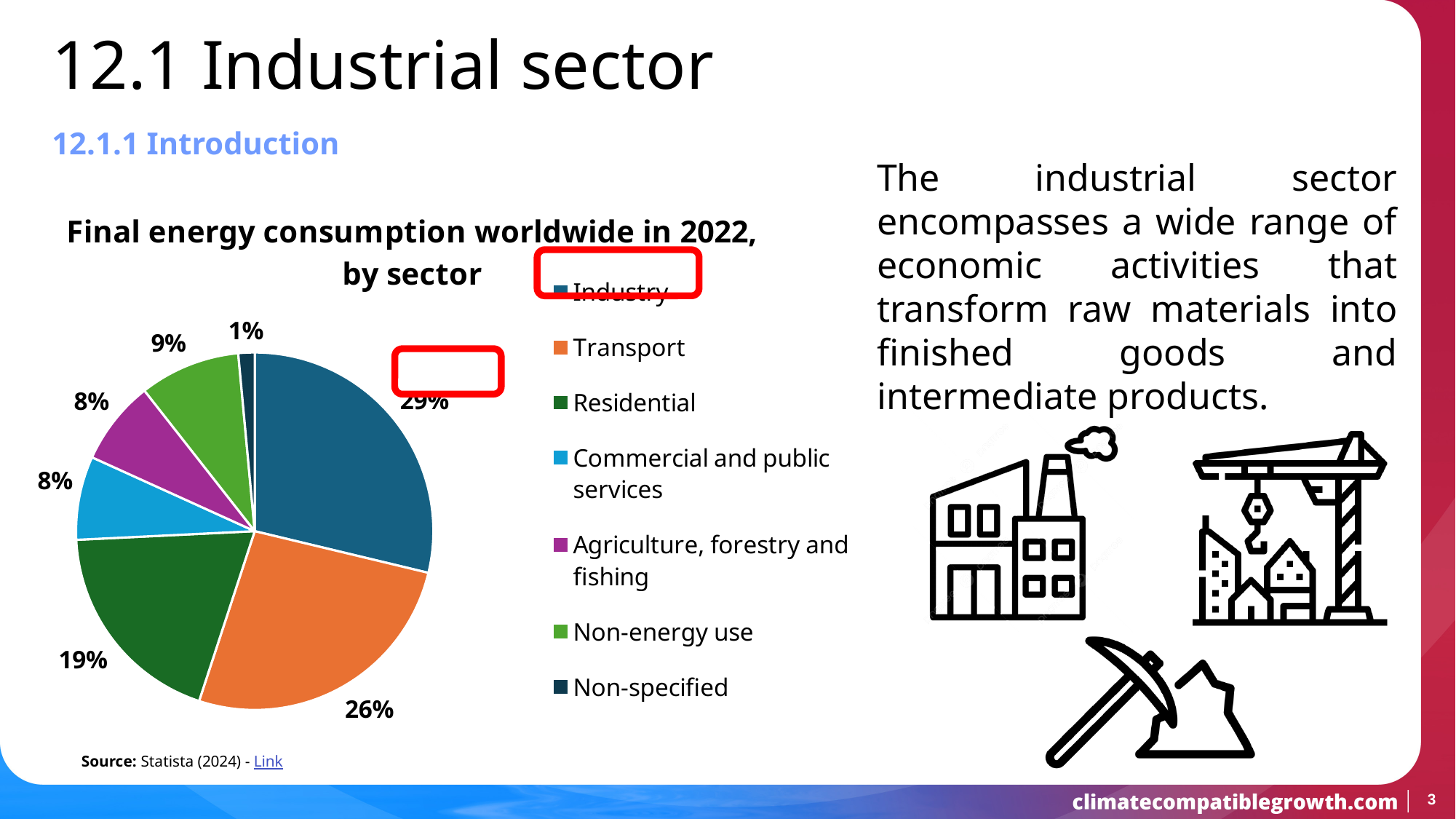
What colour is the Transport slice in the pie chart? Orange What share of final energy consumption does Residential account for? 19% What share of final energy consumption does Non-specified account for? 1% What type of chart is shown on the slide? Pie chart Which sector has the largest share of final energy consumption? Industry What share of final energy consumption does Non-energy use account for? 9% What is the difference in percentage points between the Transport and Residential shares? 7 How many sectors are listed in the chart legend? 7 What is the title of the chart? Final energy consumption worldwide in 2022, by sector Which has a larger share, Non-energy use or Commercial and public services? Non-energy use What share of final energy consumption does Transport account for? 26% Which sector has the smallest share of final energy consumption? Non-specified